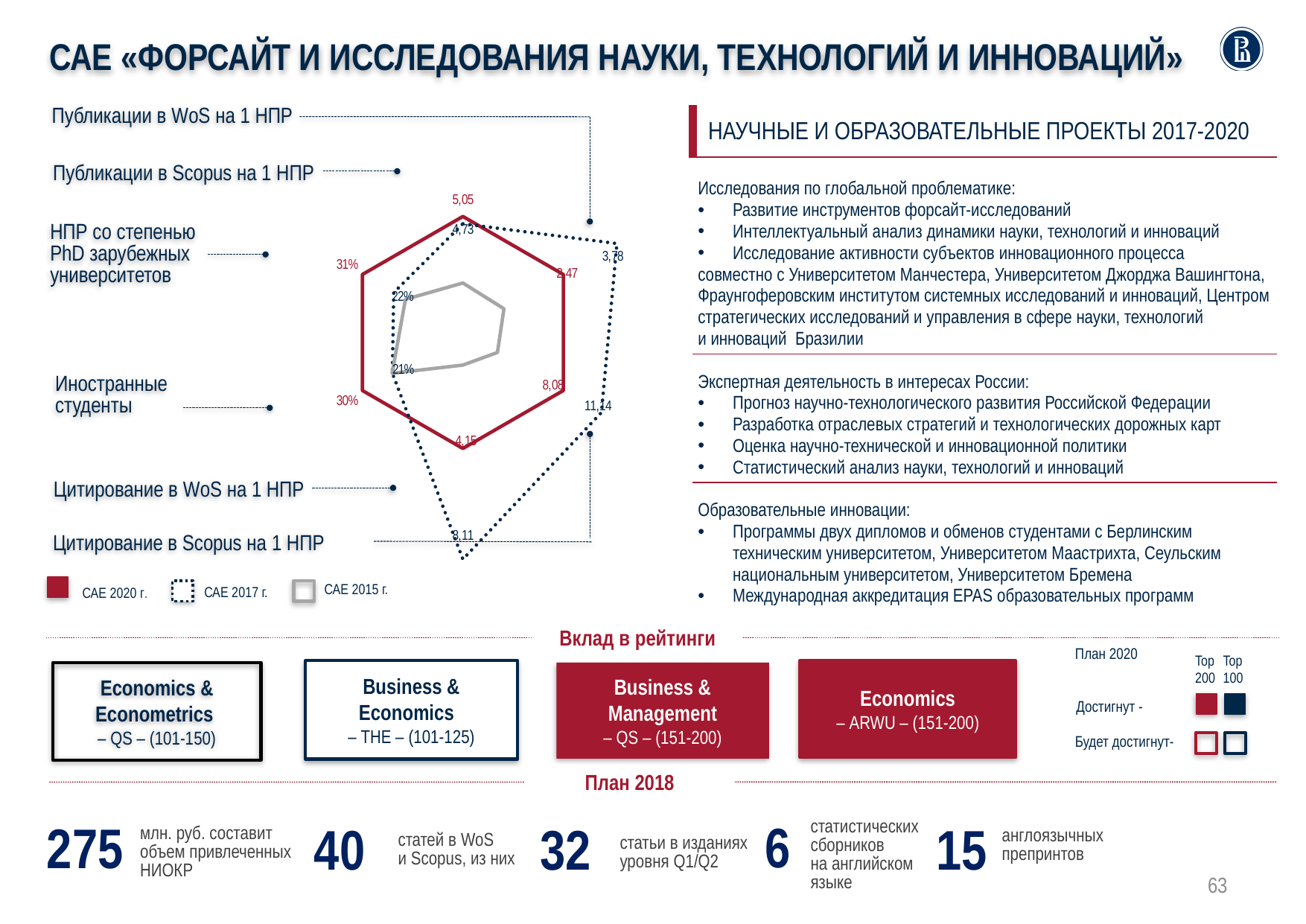
What colour is used for the САЕ 2020 г. series in the radar chart? red How many indicator axes does the radar chart have? 6 What kind of chart is shown on the left of the slide? radar chart What is the САЕ 2015 г. value for Иностранные студенты? 21% What is the САЕ 2020 г. value for Иностранные студенты? 30% What is the САЕ 2020 г. value for НПР со степенью PhD зарубежных университетов? 31% How many series does the legend of the radar chart list? 3 What is the САЕ 2017 г. value for Публикации в WoS на 1 НПР? 3,78 What is the САЕ 2020 г. value for Публикации в WoS на 1 НПР? 2,47 What are the three legend entries of the radar chart? САЕ 2020 г., САЕ 2017 г., САЕ 2015 г.